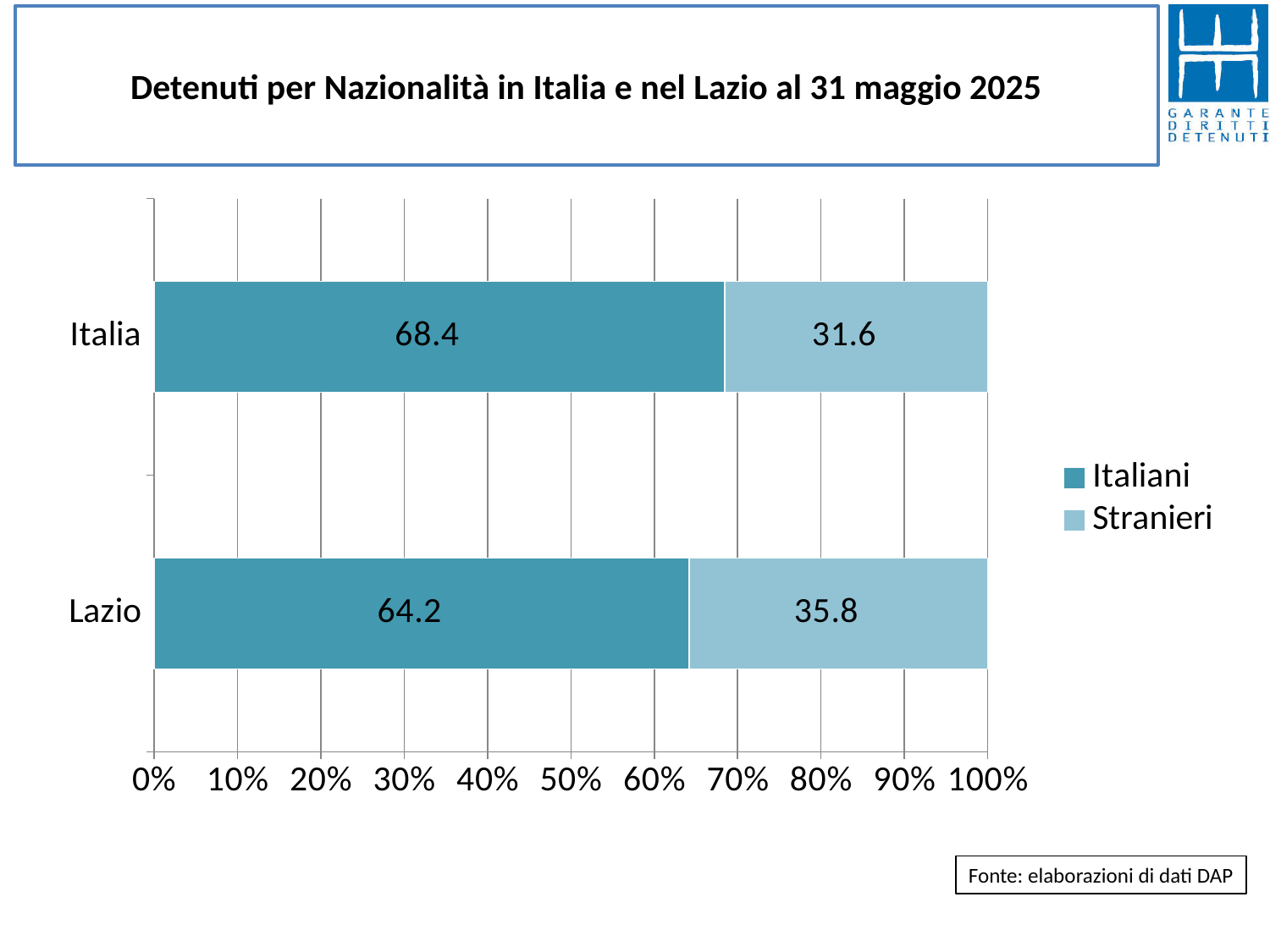
Which category has the higher value for Italiani, Italia or Lazio? Italia What is the value for Stranieri in Italia? 31.6 What kind of chart is shown on the slide? Stacked bar chart What is the difference between the Stranieri values for Lazio and Italia? 4.2 What is the value for Italiani in Italia? 68.4 How many categories are shown on the chart? 2 What is the value for Italiani in Lazio? 64.2 What is the total of the stacked bar for Lazio? 100 How many series does the legend list? 2 What is the value for Stranieri in Lazio? 35.8 Which category has the lower value for Stranieri? Italia What is the difference between the Italiani values for Italia and Lazio? 4.2